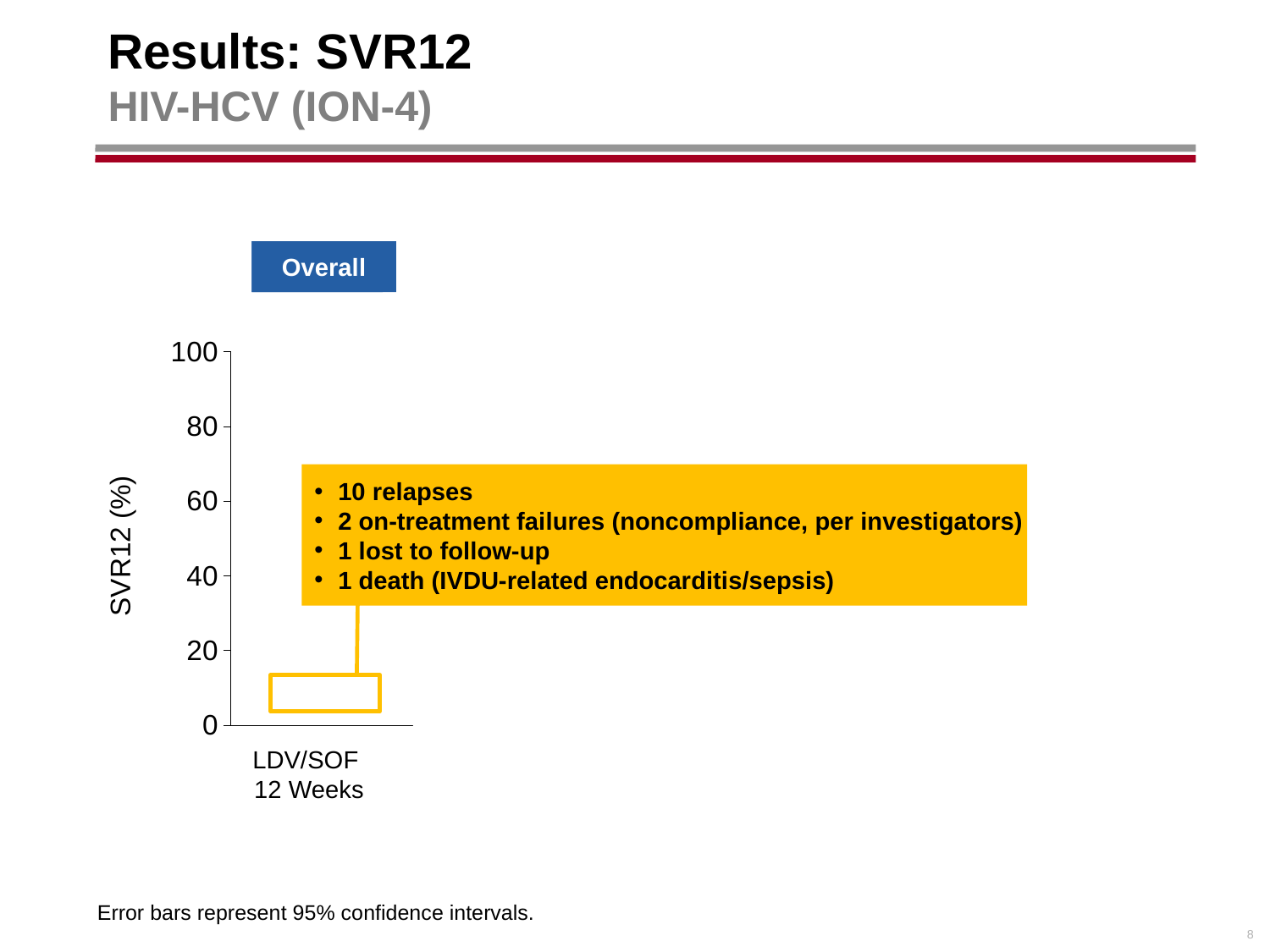
What is the label of the y axis of the chart? SVR12 (%) What is the highest tick value shown on the y axis of the chart? 100 What is the label of the single category on the x axis of the chart? LDV/SOF 12 Weeks What kind of chart is shown on the slide? bar chart How many categories are shown on the x axis of the chart? 1